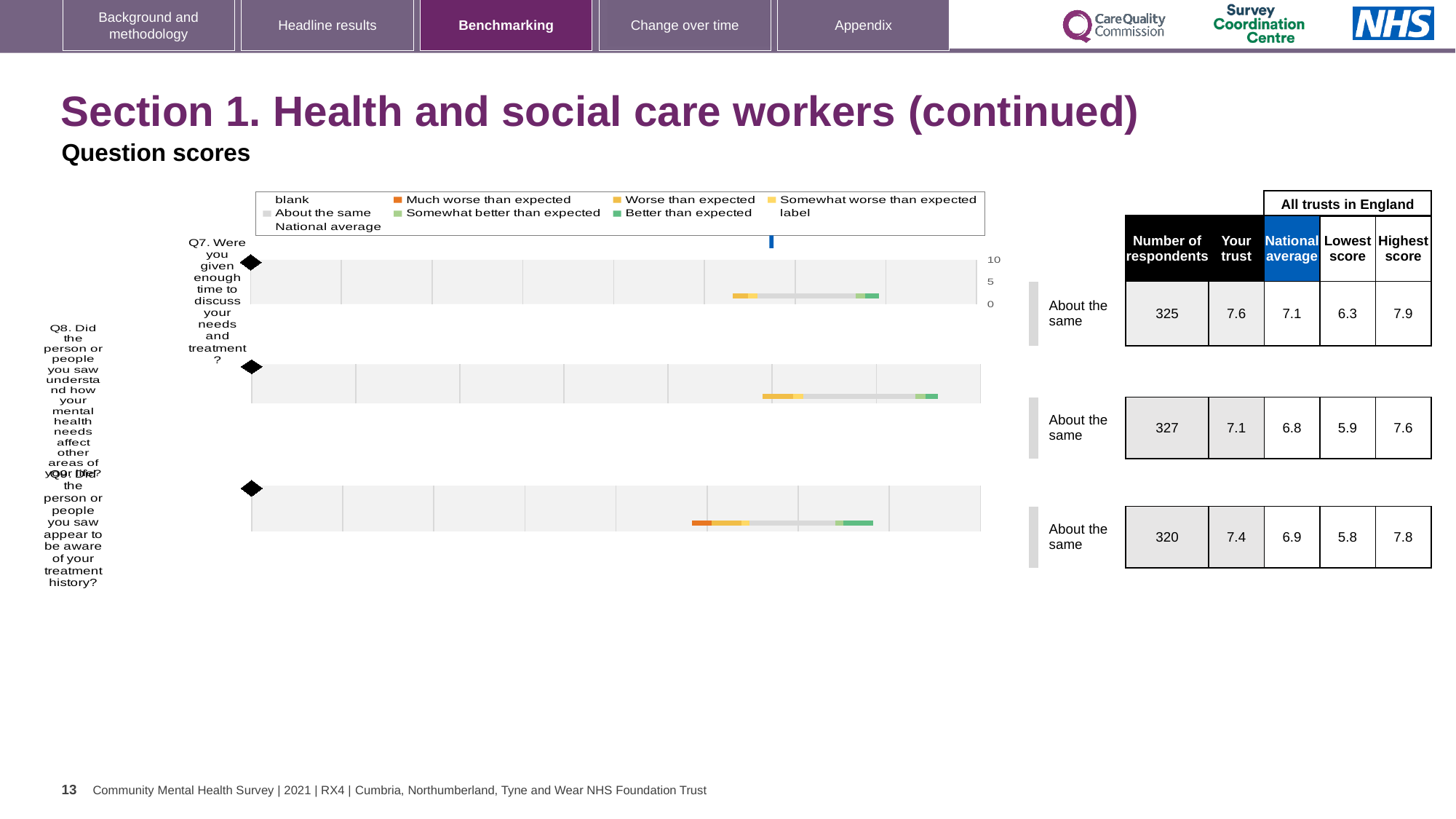
What kind of chart is used to show the benchmarking for each question? Bar chart Which has the larger 'Your trust' score, Q7 or Q9? Q7 Which of the three questions shown has the highest 'Your trust' score? Q7 What is the lowest score among all trusts in England for Q9? 5.8 How many questions are benchmarked on this slide? 3 For Q7, what is the difference between the 'Your trust' score and the national average? 0.5 Which of the three questions shown has the lowest national average score? Q8 What is the 'Your trust' score for Q8 (Did the person or people you saw understand how your mental health needs affect other areas of your life?)? 7.1 What is the national average score for Q9 (Did the person or people you saw appear to be aware of your treatment history?)? 6.9 How many respondents answered Q7 (Were you given enough time to discuss your needs and treatment?)? 325 How is the trust's result for Q8 categorised compared with other trusts? About the same What is the highest score among all trusts in England for Q7? 7.9